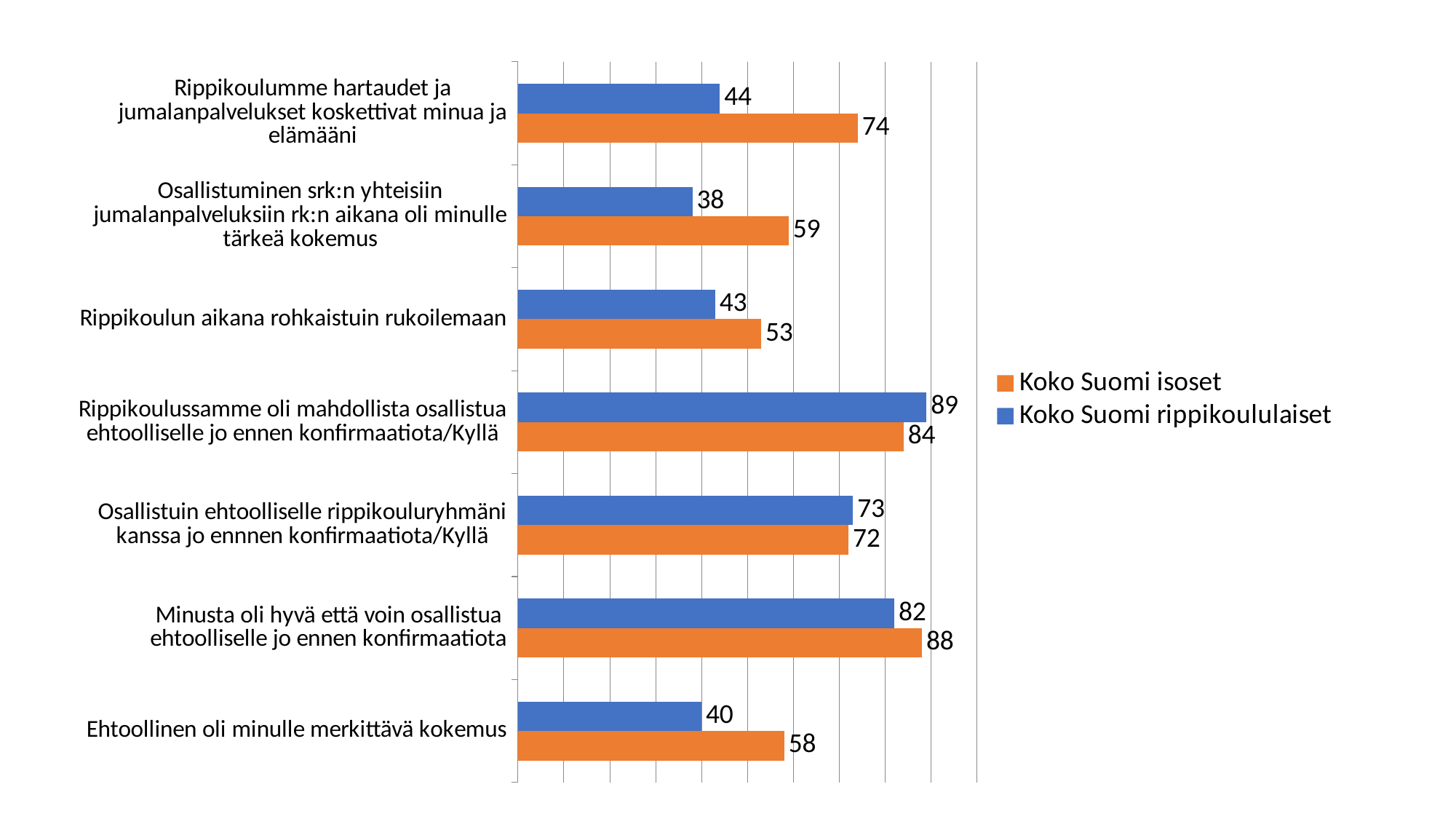
Which category has the lowest value for "Koko Suomi rippikoululaiset"? Osallistuminen srk:n yhteisiin jumalanpalveluksiin rk:n aikana oli minulle tärkeä kokemus Which category has the lowest value for "Koko Suomi isoset"? Rippikoulun aikana rohkaistuin rukoilemaan What kind of chart is shown on the slide? Bar chart For "Minusta oli hyvä että voin osallistua ehtoolliselle jo ennen konfirmaatiota", which series has the larger value? Koko Suomi isoset Which category has the highest value for "Koko Suomi rippikoululaiset"? Rippikoulussamme oli mahdollista osallistua ehtoolliselle jo ennen konfirmaatiota/Kyllä What is the difference between "Koko Suomi isoset" and "Koko Suomi rippikoululaiset" for "Rippikoulumme hartaudet ja jumalanpalvelukset koskettivat minua ja elämääni"? 30 What is the difference between "Koko Suomi isoset" and "Koko Suomi rippikoululaiset" for "Ehtoollinen oli minulle merkittävä kokemus"? 18 What is the value for "Koko Suomi rippikoululaiset" for "Ehtoollinen oli minulle merkittävä kokemus"? 40 How many categories are shown on the chart? 7 How many series does the legend list? 2 What is the value for "Koko Suomi isoset" for "Rippikoulumme hartaudet ja jumalanpalvelukset koskettivat minua ja elämääni"? 74 What is the value for "Koko Suomi rippikoululaiset" for "Osallistuin ehtoolliselle rippikouluryhmäni kanssa jo ennnen konfirmaatiota/Kyllä"? 73